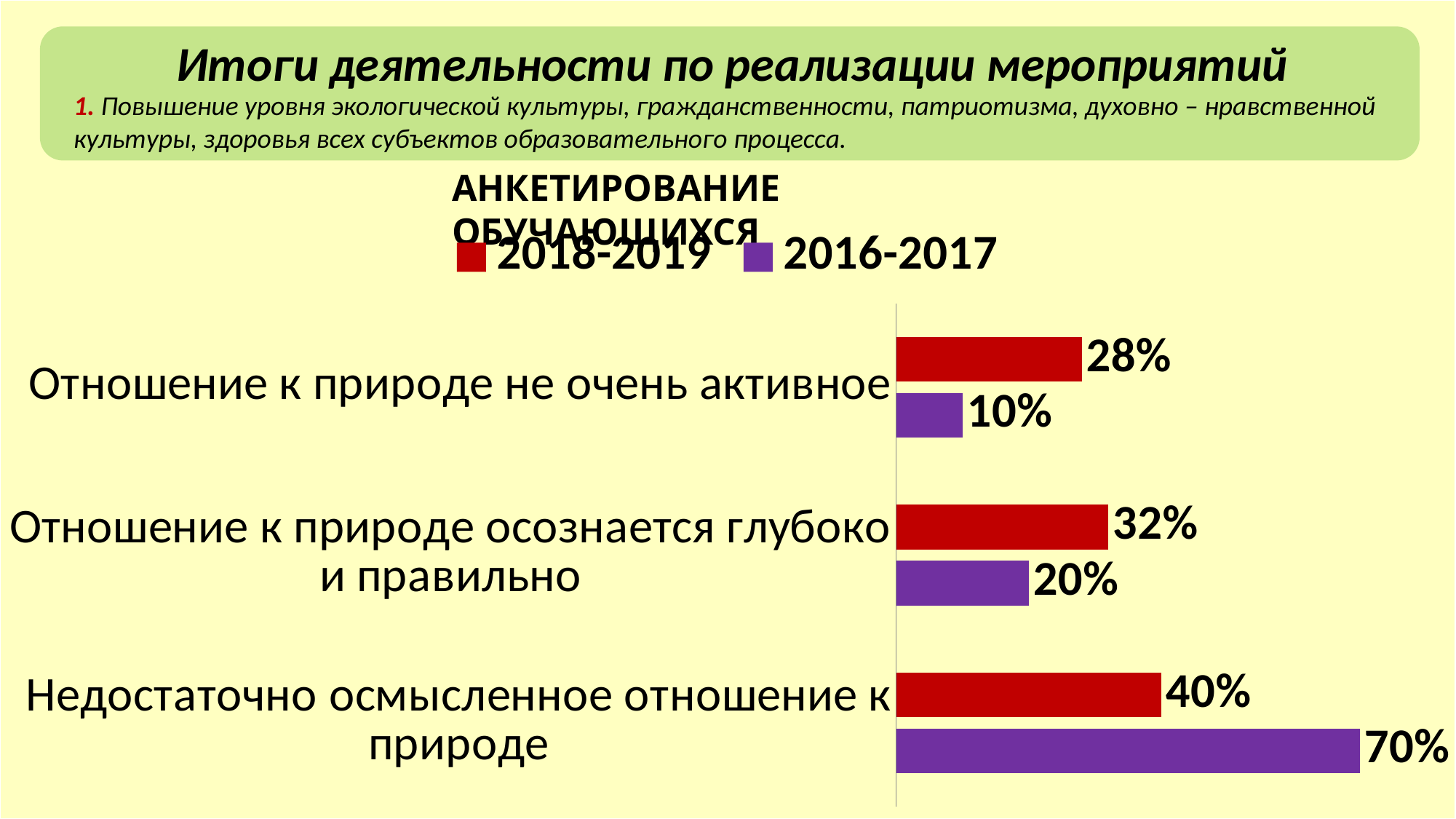
What kind of chart is shown on the slide? Bar chart For "Отношение к природе осознается глубоко и правильно", which series has the larger value, 2018-2019 or 2016-2017? 2018-2019 Which category has the highest 2016-2017 value? Недостаточно осмысленное отношение к природе Which category has the lowest 2018-2019 value? Отношение к природе не очень активное What colour represents the 2016-2017 series? Purple What is the difference between the 2016-2017 and 2018-2019 values for "Недостаточно осмысленное отношение к природе"? 30% How many series does the legend list? 2 What is the 2016-2017 value for "Отношение к природе не очень активное"? 10% How many categories are shown in the chart? 3 What is the 2016-2017 value for "Недостаточно осмысленное отношение к природе"? 70% What is the 2018-2019 value for "Отношение к природе не очень активное"? 28% What is the 2018-2019 value for "Отношение к природе осознается глубоко и правильно"? 32%